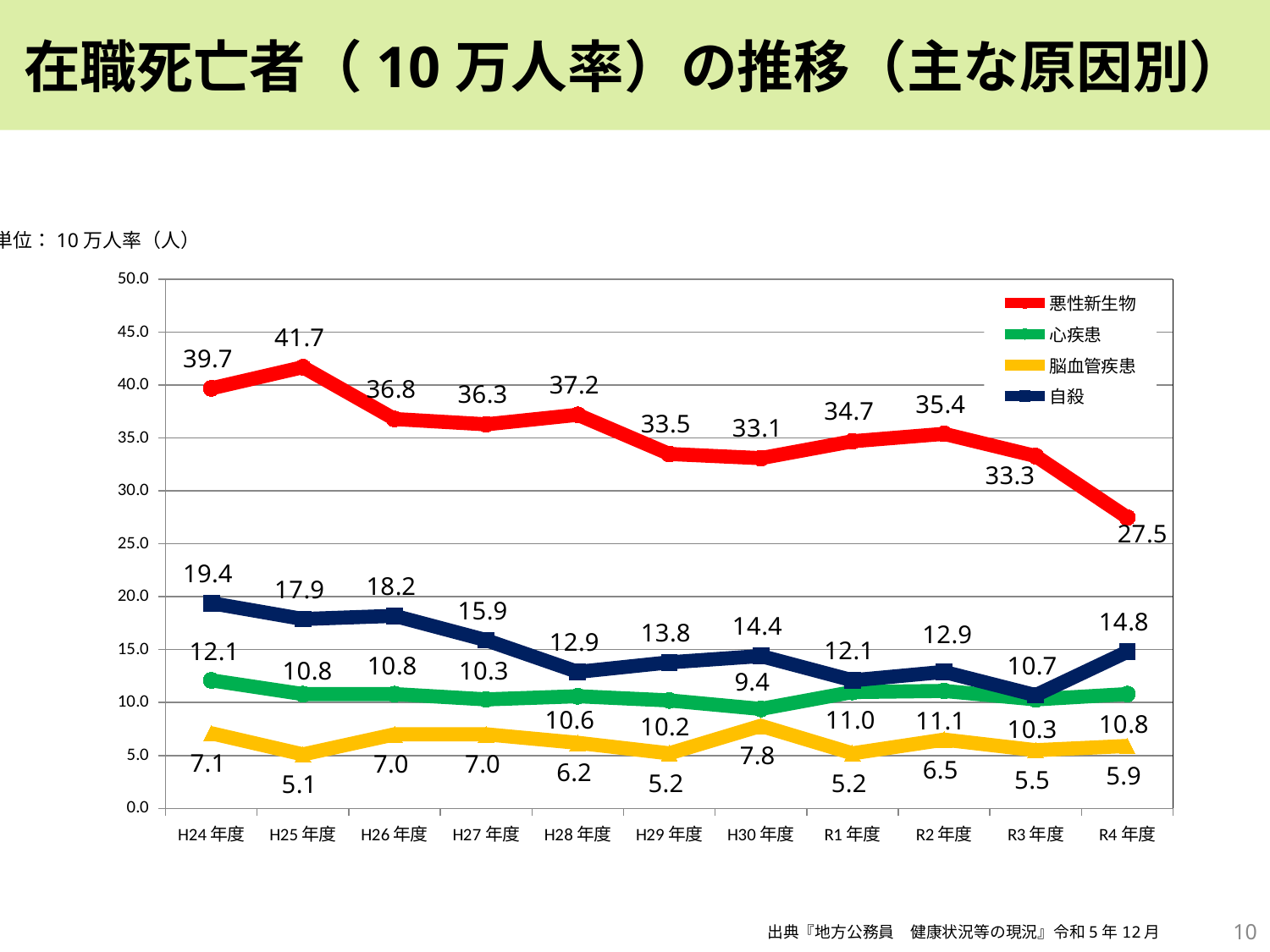
What is the value for 脳血管疾患 in H30年度? 7.8 In which fiscal year is the value for 悪性新生物 the lowest? R4年度 What is the difference between the 悪性新生物 values in H25年度 and R4年度? 14.2 In which fiscal year is the value for 自殺 the highest? H24年度 How many fiscal years are plotted along the x axis? 11 What colour is the line for 自殺? Navy blue What is the value for 自殺 in R4年度? 14.8 How many series does the legend list? 4 Does the value for 悪性新生物 generally rise or fall from H24年度 to R4年度? Fall What is the value for 悪性新生物 in H25年度? 41.7 Which is larger in H24年度, the value for 心疾患 or the value for 脳血管疾患? 心疾患 What type of chart is shown on the slide? Line chart